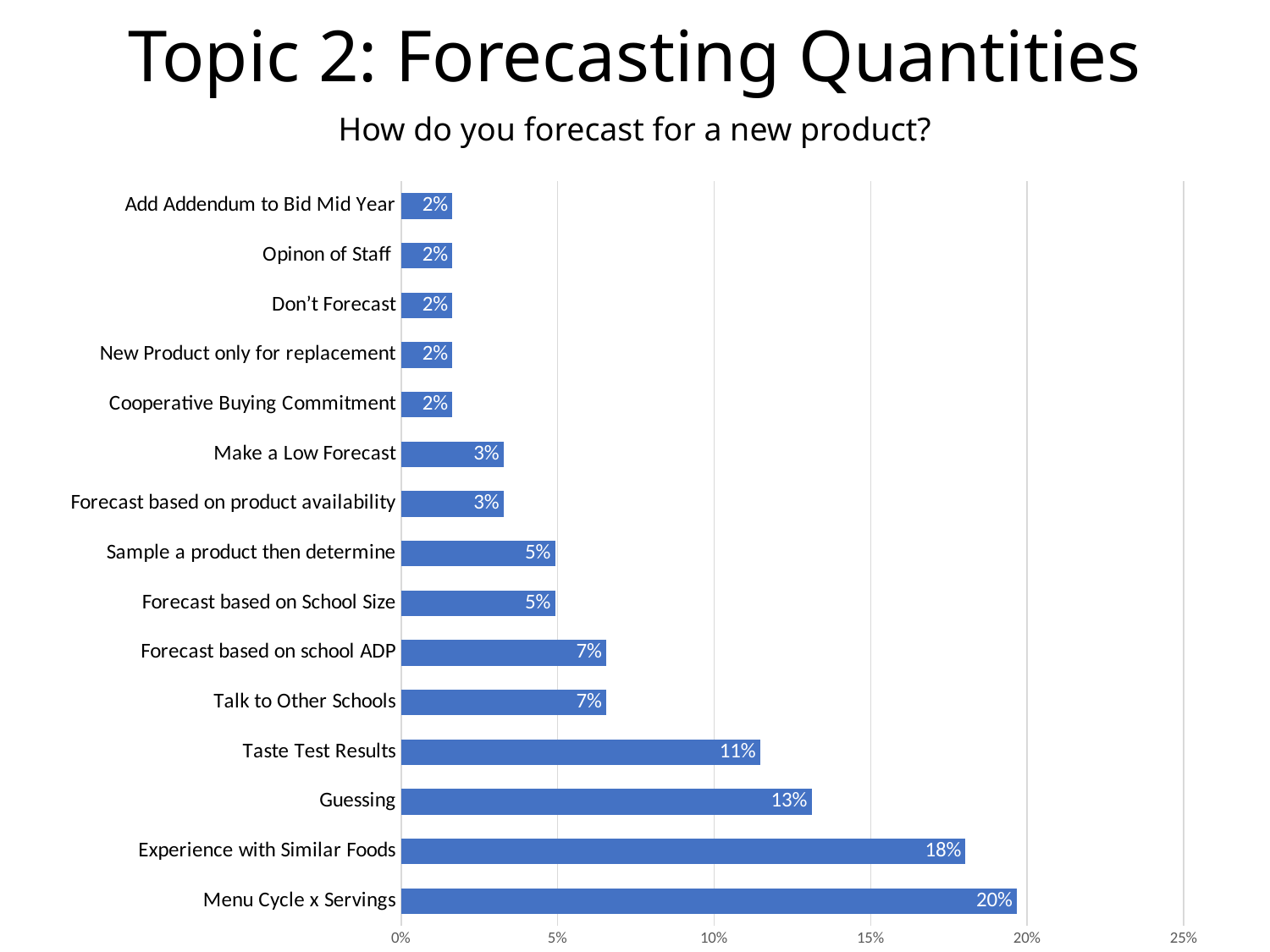
What is the difference between Menu Cycle x Servings and Experience with Similar Foods? 2% What percentage is shown for Taste Test Results? 11% What is the difference between Guessing and Taste Test Results? 2% What percentage is shown for Forecast based on School Size? 5% Is the value for Experience with Similar Foods greater or less than 15%? greater How many categories are shown in the chart? 15 What percentage is shown for Menu Cycle x Servings? 20% What question does the chart answer, according to the subtitle? How do you forecast for a new product? Which is larger, Talk to Other Schools or Make a Low Forecast? Talk to Other Schools Which category has the highest value? Menu Cycle x Servings What kind of chart is shown on the slide? bar chart What percentage is shown for Guessing? 13%